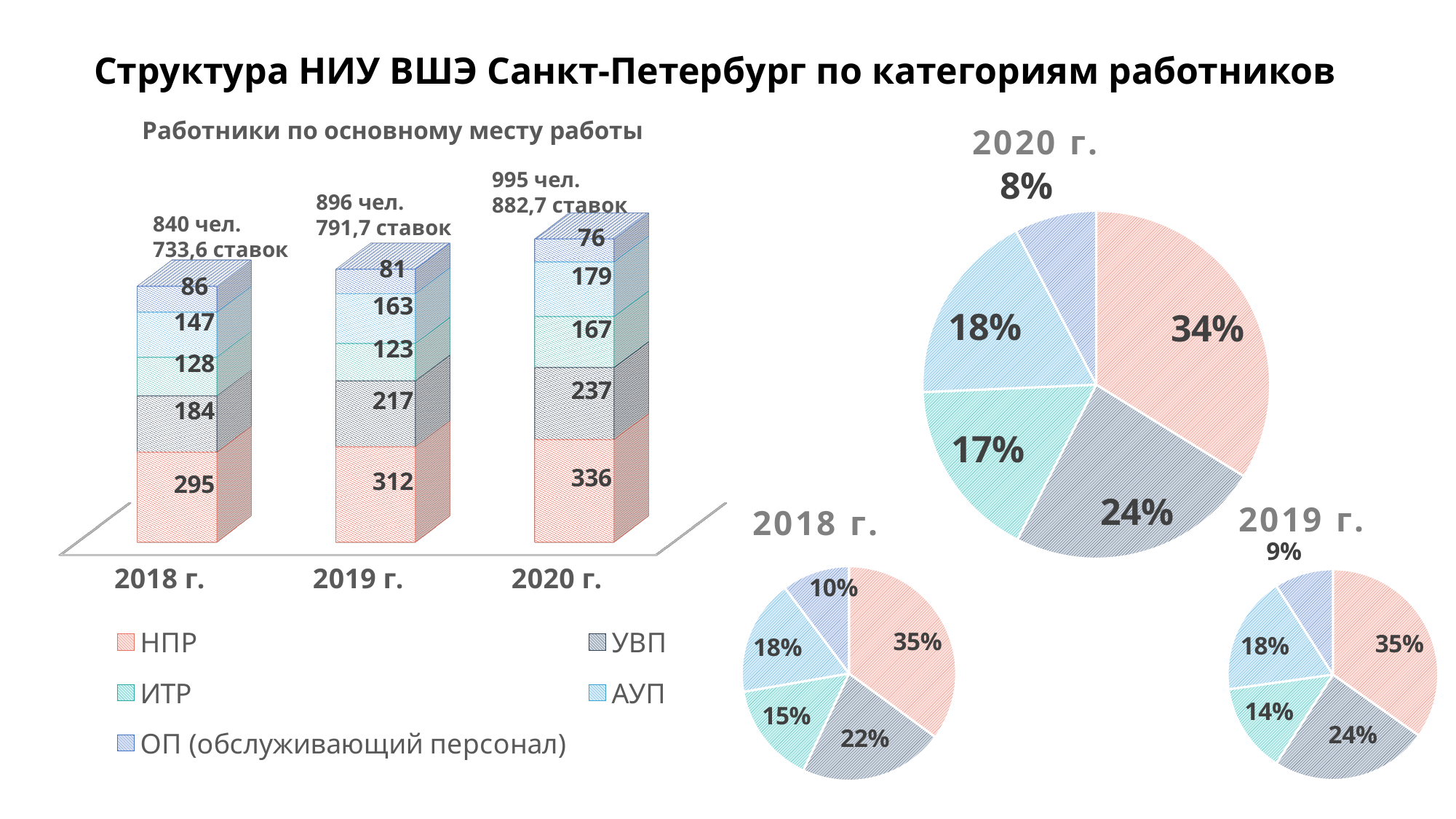
In the stacked bar chart 'Работники по основному месту работы', what is the value for НПР in 2020 г.? 336 In the pie chart for 2020 г., what share does the largest slice (НПР) have? 34% How many series does the legend of the stacked bar chart list? 5 In the pie chart for 2018 г., which is larger: the УВП slice or the ИТР slice? УВП In the stacked bar chart 'Работники по основному месту работы', does the ОП (обслуживающий персонал) value rise or fall from 2018 г. to 2020 г.? fall In the pie chart for 2019 г., what share does the smallest slice (ОП) have? 9% In the stacked bar chart 'Работники по основному месту работы', which year has the highest total number of employees? 2020 г. In the stacked bar chart 'Работники по основному месту работы', what is the total number of employees (чел.) shown for 2020 г.? 995 чел. In the stacked bar chart 'Работники по основному месту работы', what is the value for УВП in 2019 г.? 217 In the stacked bar chart 'Работники по основному месту работы', how much larger is the НПР value in 2020 г. than in 2018 г.? 41 In the stacked bar chart 'Работники по основному месту работы', what is the value for ОП (обслуживающий персонал) in 2018 г.? 86 What kind of chart is 'Работники по основному месту работы'? stacked bar chart